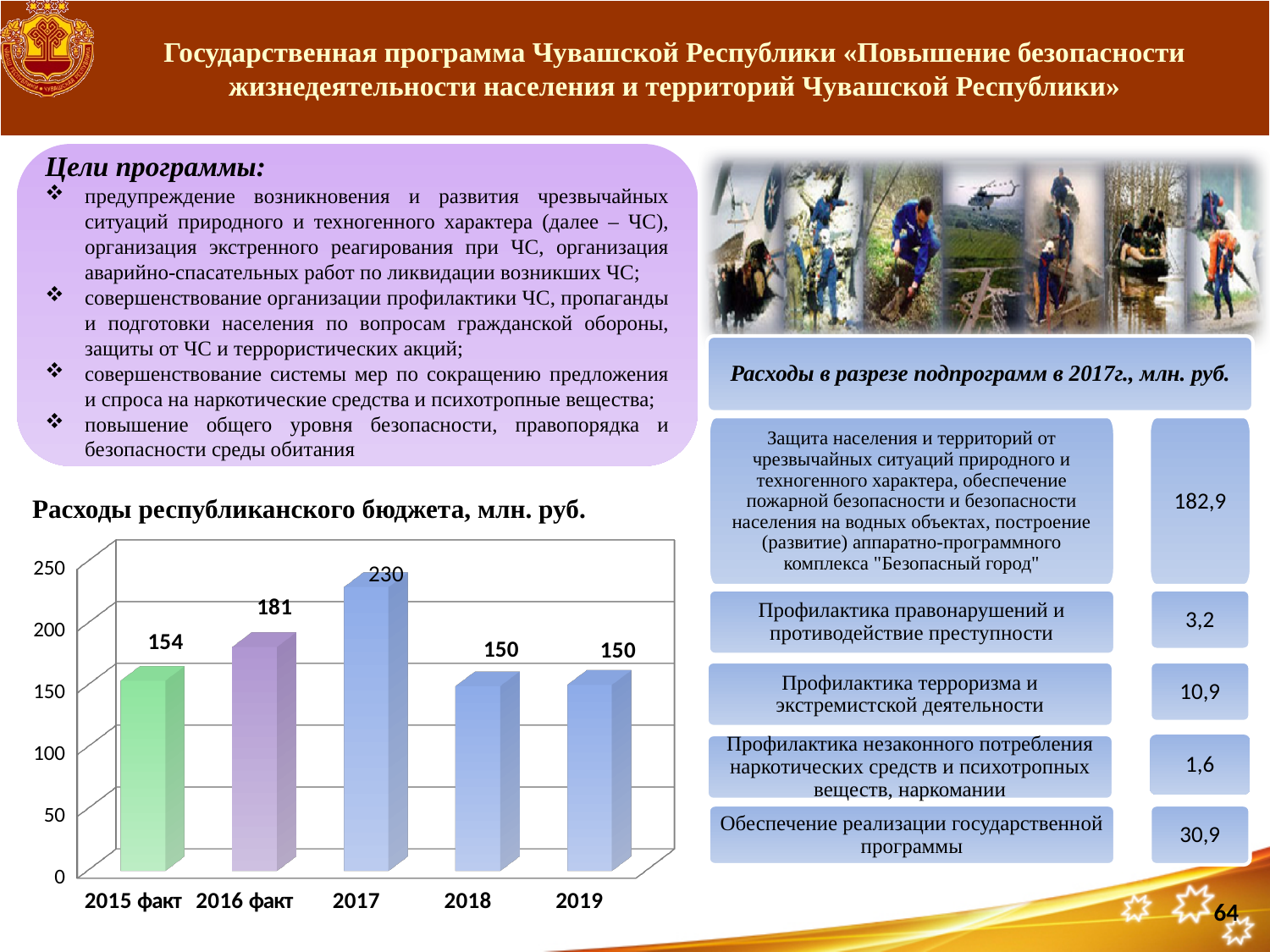
What kind of chart is "Расходы республиканского бюджета, млн. руб."? bar chart What is the maximum value shown on the vertical axis of the chart "Расходы республиканского бюджета, млн. руб."? 250 What is the difference between the values for 2017 and 2016 факт in the chart "Расходы республиканского бюджета, млн. руб."? 49 What is the value for 2019 in the chart "Расходы республиканского бюджета, млн. руб."? 150 What is the value for 2015 факт in the chart "Расходы республиканского бюджета, млн. руб."? 154 Which is larger in the chart "Расходы республиканского бюджета, млн. руб.": the value for 2015 факт or the value for 2018? 2015 факт What is the value for 2017 in the chart "Расходы республиканского бюджета, млн. руб."? 230 Which year has the highest value in the chart "Расходы республиканского бюджета, млн. руб."? 2017 What is the difference between the values for 2016 факт and 2015 факт in the chart "Расходы республиканского бюджета, млн. руб."? 27 How many categories are shown on the x axis of the chart "Расходы республиканского бюджета, млн. руб."? 5 Is the value for 2017 in the chart "Расходы республиканского бюджета, млн. руб." greater or less than 200? greater What is the value for 2016 факт in the chart "Расходы республиканского бюджета, млн. руб."? 181